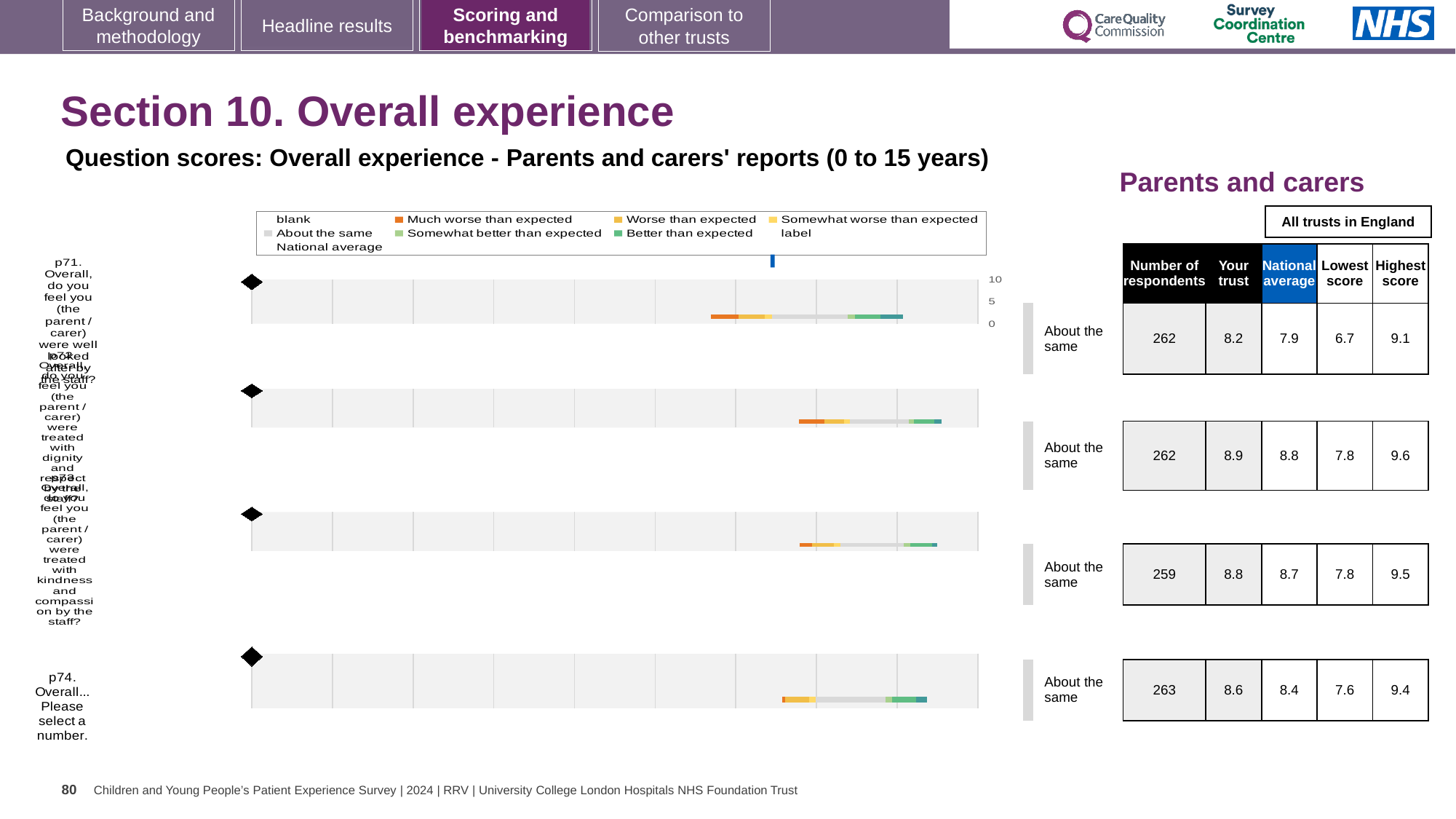
In the table, what is the Highest score for the second row? 9.6 What benchmark category is shown next to each of the four charts? About the same Which row has the highest 'Your trust' score in the table? the second row (8.9) What kind of chart is used for the four question rows on the slide? bar chart How many question rows (charts) are shown on the slide? 4 For the bottom row (p74), which is larger: the 'Your trust' score or the National average? Your trust In the table, what is the 'Your trust' score for the bottom row (p74. Overall... Please select a number)? 8.6 How many entries does the legend above the charts list? 9 Which row has the lowest 'Your trust' score in the table? the first row, p71 (8.2) In the table, what is the Number of respondents for the third row? 259 In the table, what is the National average for the first row (p71)? 7.9 For the first row (p71), what is the difference between the 'Your trust' score and the National average? 0.3